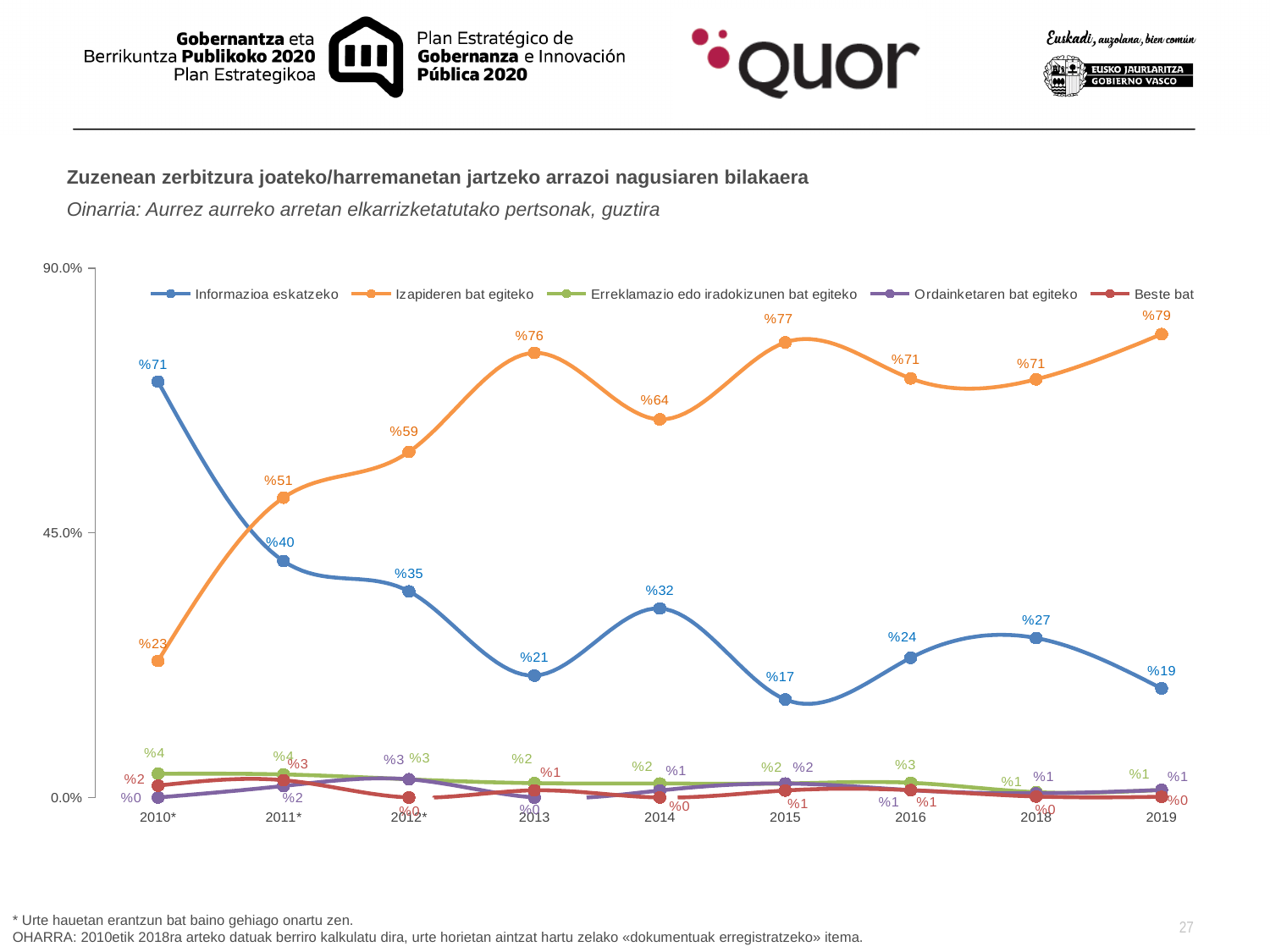
Which series is shown in orange in the legend? Izapideren bat egiteko In which year is Informazioa eskatzeko lowest? 2015 Which is larger in 2010*, Informazioa eskatzeko or Izapideren bat egiteko? Informazioa eskatzeko How many series does the legend list? 5 What type of chart is shown on the slide? line chart Does Informazioa eskatzeko generally rise or fall from 2010* to 2019? fall What is the value for Informazioa eskatzeko in 2010*? %71 In which year is Izapideren bat egiteko highest? 2019 What is the value for Izapideren bat egiteko in 2019? %79 What is the difference between Izapideren bat egiteko and Informazioa eskatzeko in 2015? 60 percentage points How many years are plotted along the x axis? 9 What is the value for Izapideren bat egiteko in 2013? %76